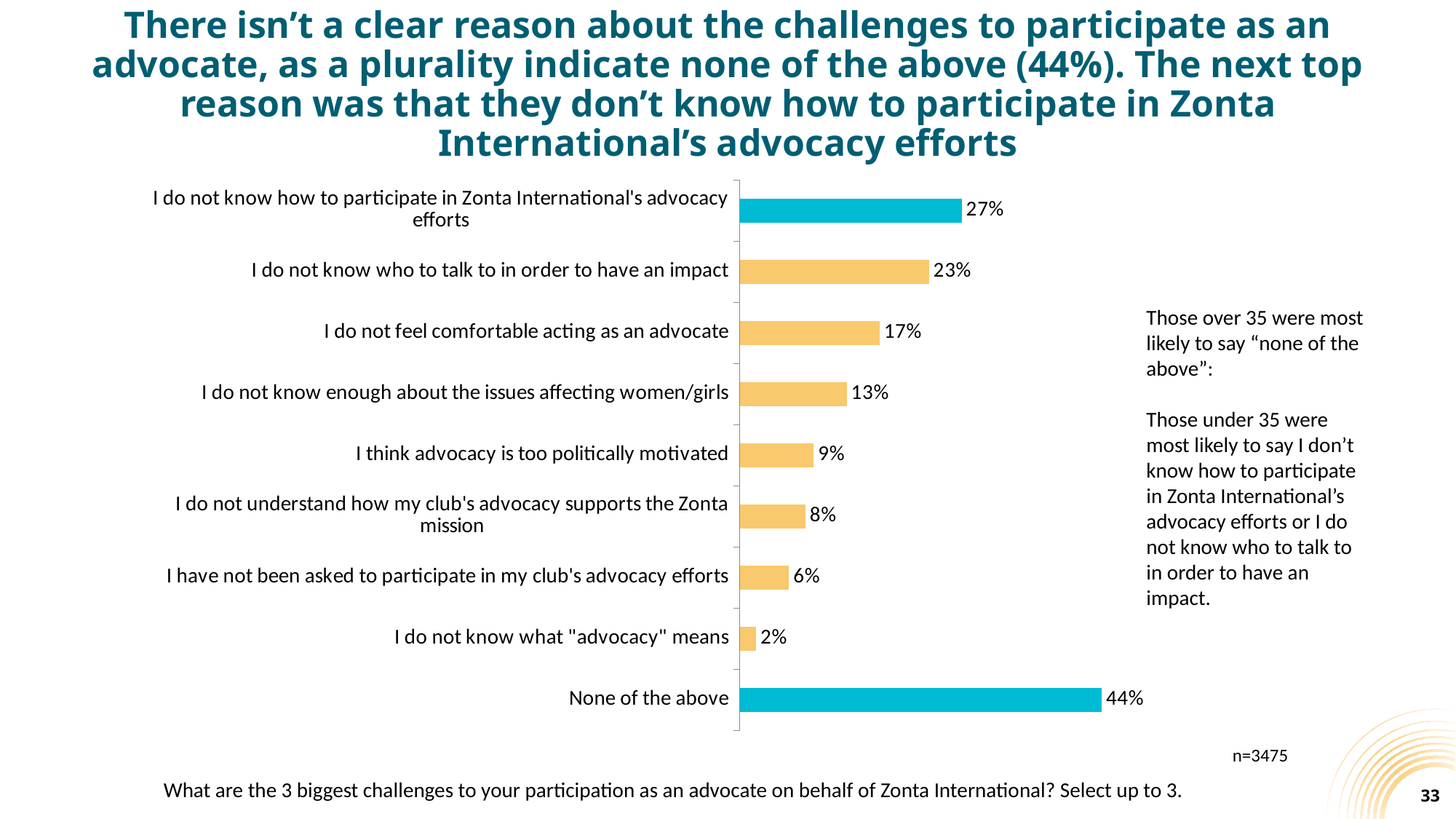
What is the difference between "None of the above" and "I do not know enough about the issues affecting women/girls"? 31% What percentage said "I do not feel comfortable acting as an advocate"? 17% Which category has the highest value? None of the above Which is larger: "I think advocacy is too politically motivated" or "I have not been asked to participate in my club's advocacy efforts"? I think advocacy is too politically motivated What is the difference between "I do not know how to participate in Zonta International's advocacy efforts" and "I do not know who to talk to in order to have an impact"? 4% What is the sample size (n) shown on the slide? n=3475 What is the value for "I do not know what "advocacy" means"? 2% Which category has the lowest value? I do not know what "advocacy" means What percentage of respondents selected "None of the above"? 44% What kind of chart is shown on the slide? Bar chart How many categories are shown in the chart? 9 What is the value for "I do not know how to participate in Zonta International's advocacy efforts"? 27%